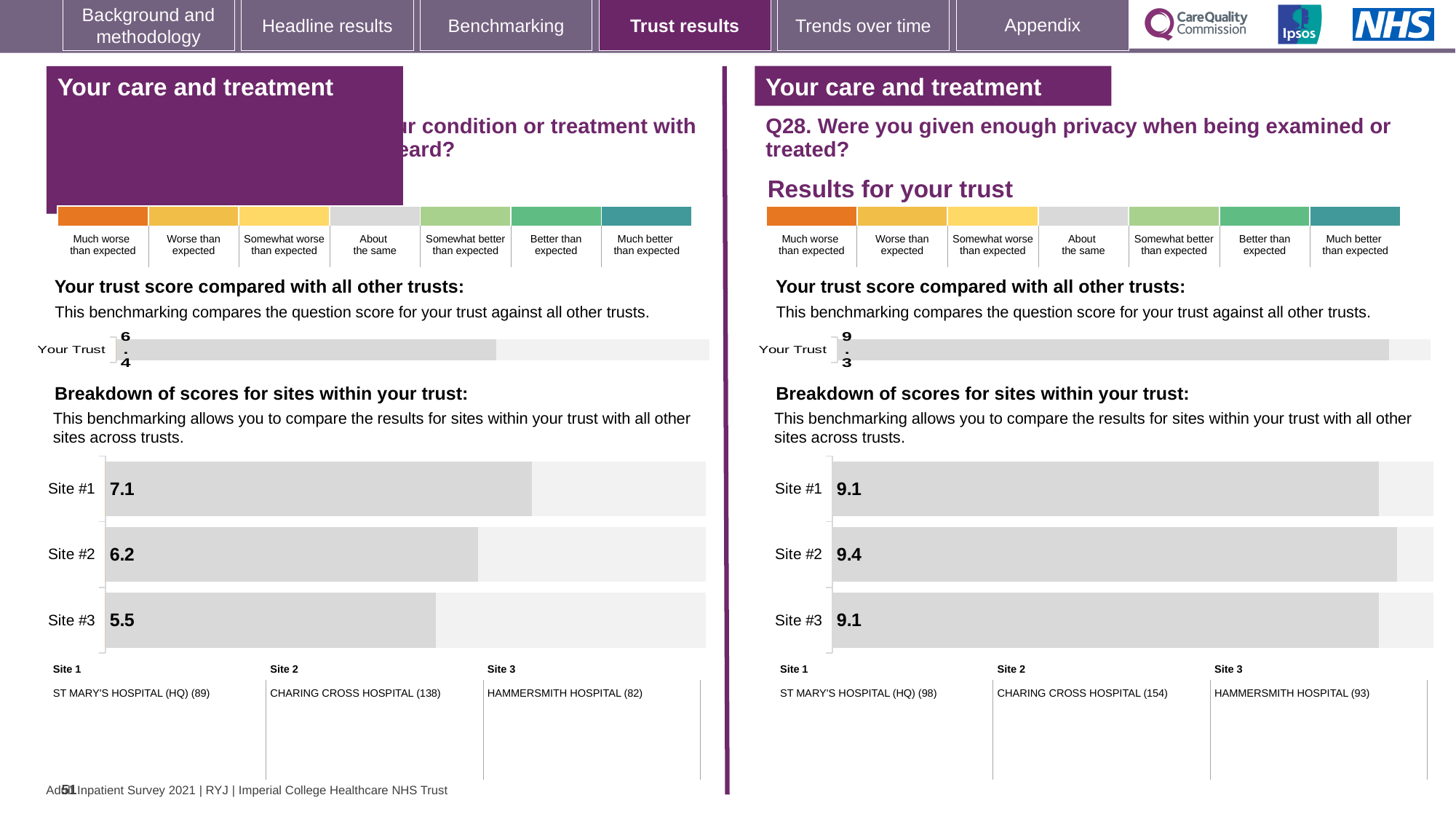
On the right-hand (Q28) 'Your trust score compared with all other trusts' chart, what is the value shown for Your Trust? 9.3 What type of chart is used for the site breakdown on the left-hand side of the slide? Bar chart On the right-hand (Q28) site breakdown chart, what is the score for Site #2? 9.4 On the left-hand site breakdown chart, which has the larger score, Site #1 or Site #2? Site #1 On the left-hand site breakdown chart, what is the score for Site #3? 5.5 On the left-hand site breakdown chart, which site has the highest score? Site #1 On the right-hand (Q28) site breakdown chart, what is the difference between the scores for Site #2 and Site #1? 0.3 How many sites are shown on the right-hand (Q28) site breakdown chart? 3 On the left-hand 'Your trust score compared with all other trusts' chart, what is the value shown for Your Trust? 6.4 On the left-hand site breakdown chart, what is the difference between the scores for Site #1 and Site #3? 1.6 On the left-hand site breakdown chart, which site has the lowest score? Site #3 On the right-hand (Q28) site breakdown chart, which site has the highest score? Site #2